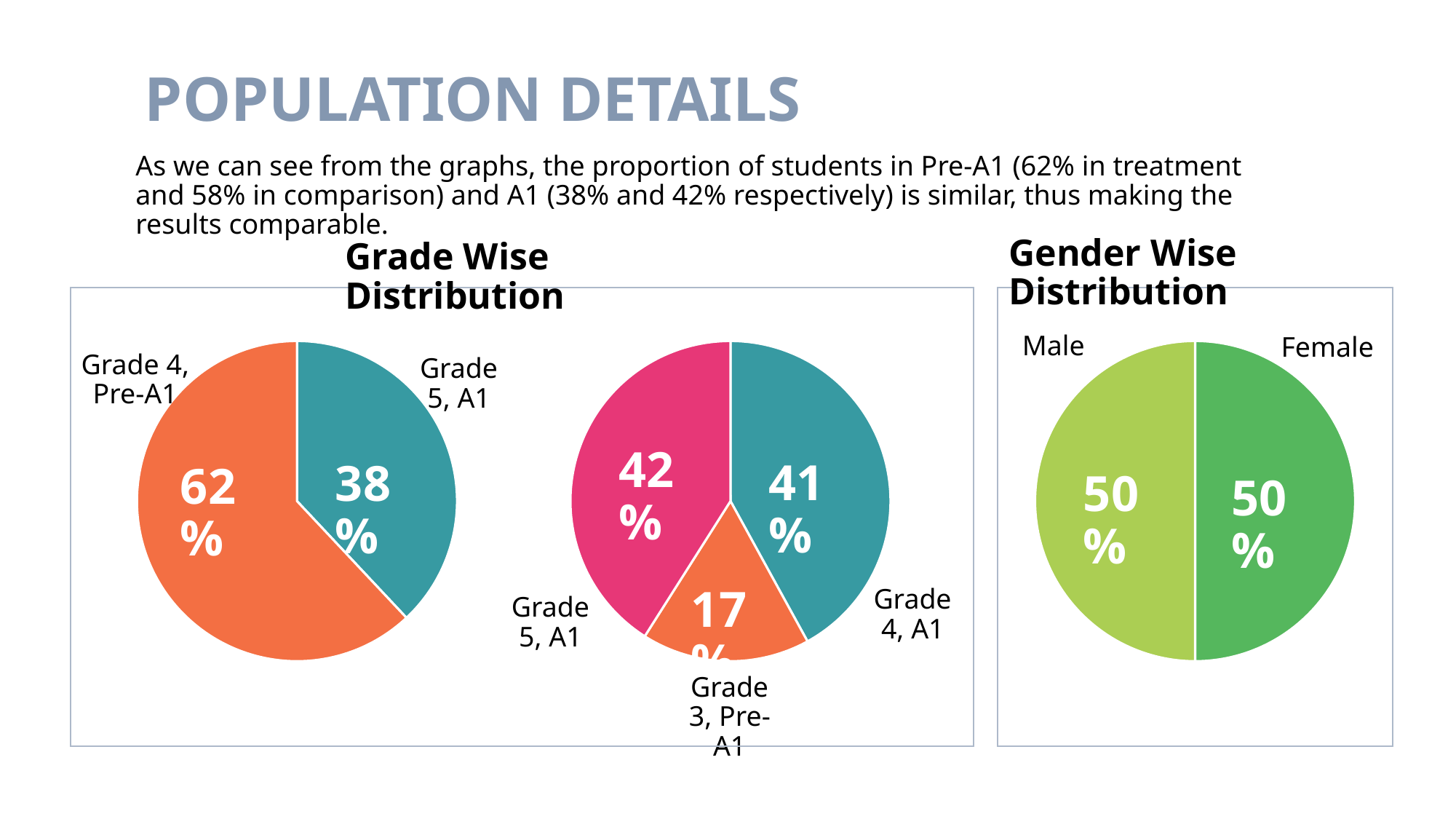
In the left pie chart under Grade Wise Distribution, what share is labelled for Grade 4, Pre-A1? 62% In the left pie chart under Grade Wise Distribution, which category has the largest slice? Grade 4, Pre-A1 In the middle pie chart under Grade Wise Distribution, what is the difference between the Grade 5, A1 share and the Grade 3, Pre-A1 share? 25% What kind of chart is the Gender Wise Distribution chart? Pie chart In the middle pie chart under Grade Wise Distribution, what share is labelled for Grade 4, A1? 41% In the Gender Wise Distribution chart, what colour is the Female slice? Green In the middle pie chart under Grade Wise Distribution, which category has the smallest slice? Grade 3, Pre-A1 In the middle pie chart under Grade Wise Distribution, how many slices are there? 3 In the middle pie chart under Grade Wise Distribution, what share is labelled for Grade 3, Pre-A1? 17% In the left pie chart under Grade Wise Distribution, what share is labelled for Grade 5, A1? 38% In the left pie chart under Grade Wise Distribution, what is the difference between the Grade 4, Pre-A1 share and the Grade 5, A1 share? 24% In the Gender Wise Distribution chart, what share is labelled for Male? 50%